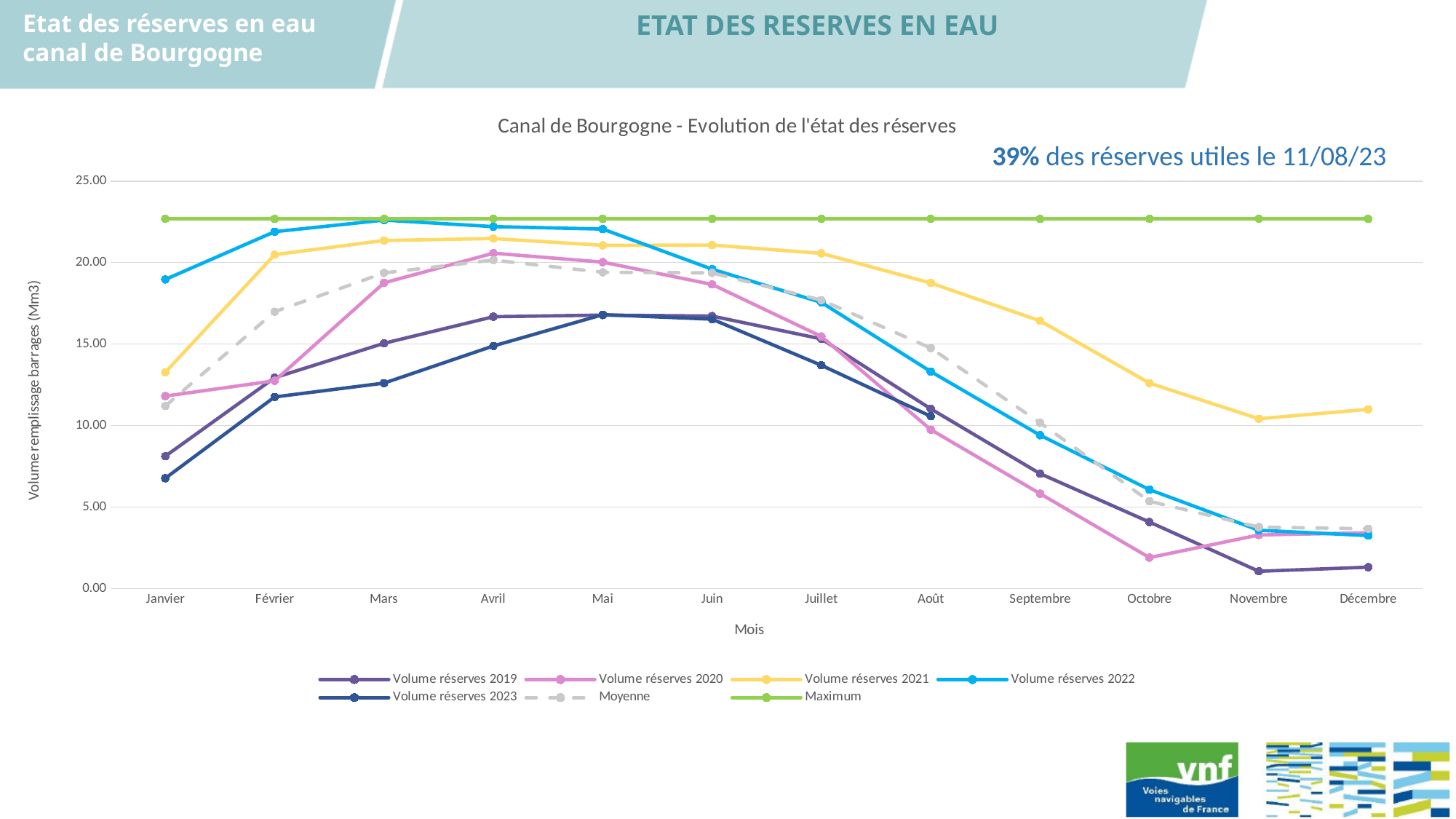
Is the Maximum line greater or less than 20? greater What is the title of the chart? Canal de Bourgogne - Evolution de l'état des réserves How many series does the legend list? 7 In which month is Volume réserves 2020 at its lowest? Octobre Is the value for Volume réserves 2022 in Janvier greater or less than 15? greater Is the value for Volume réserves 2021 in Octobre greater or less than 10? greater How many months are shown on the x axis? 12 What percentage of useful reserves is stated for 11/08/23? 39% In Juin, which is larger: Volume réserves 2022 or Volume réserves 2019? Volume réserves 2022 Which series has the highest value in Décembre, excluding the Maximum line? Volume réserves 2021 What kind of chart is shown on the slide? line chart